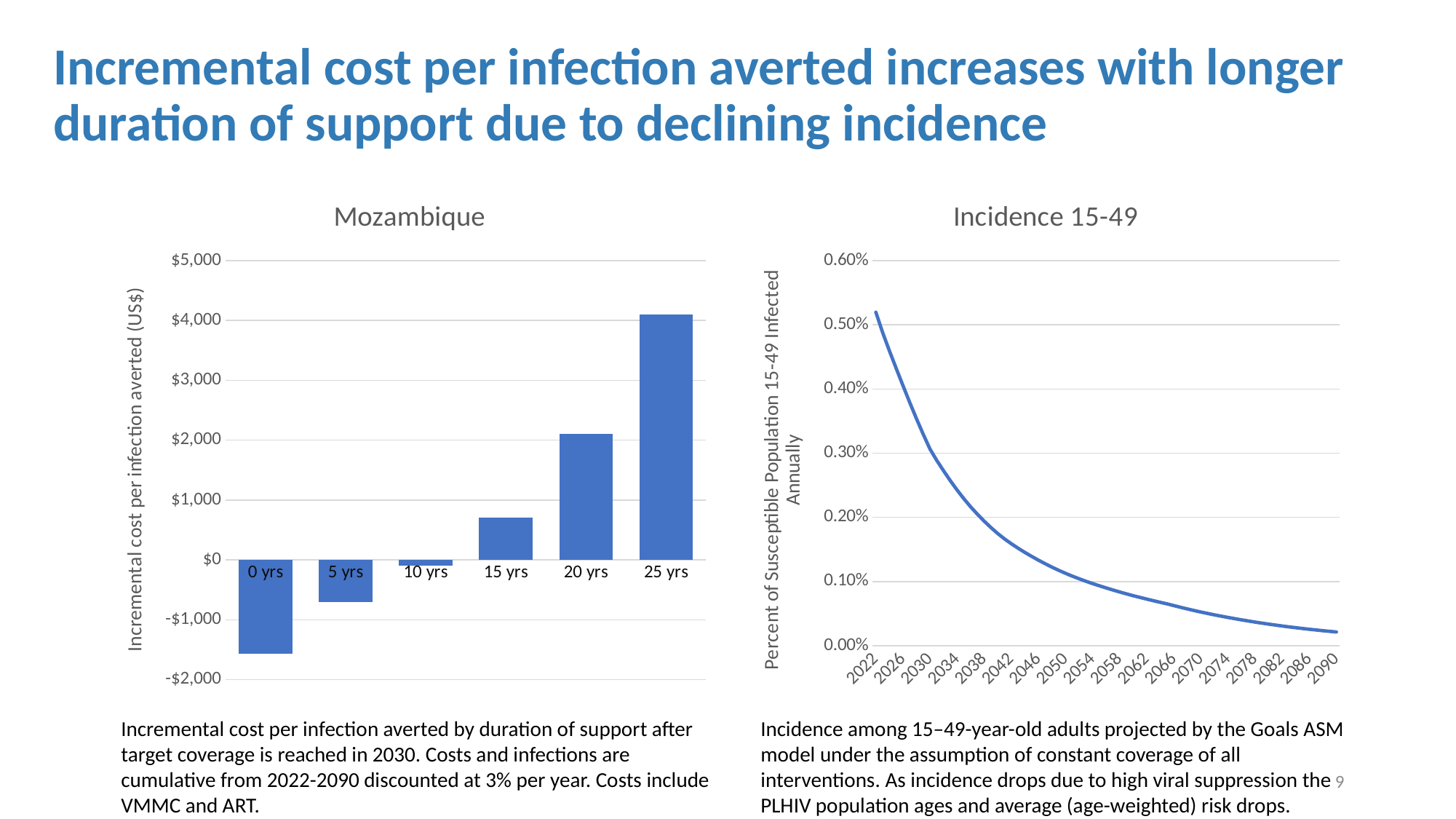
In the Mozambique chart, is the value for 25 yrs greater or less than $4,000? greater What is the y-axis label of the Mozambique chart? Incremental cost per infection averted (US$) In the Incidence 15-49 chart, is the value for 2022 greater or less than 0.50%? greater In the Mozambique chart, is the value for 20 yrs greater or less than $2,000? greater What kind of chart is the Incidence 15-49 chart? line chart In the Mozambique chart, which duration of support has the lowest incremental cost per infection averted? 0 yrs In the Mozambique chart, which duration of support has the highest incremental cost per infection averted? 25 yrs In the Incidence 15-49 chart, does incidence rise or fall from 2022 to 2090? fall In the Mozambique chart, which is larger, the value for 15 yrs or the value for 20 yrs? 20 yrs How many duration categories are shown in the Mozambique chart? 6 What kind of chart is the Mozambique chart? bar chart